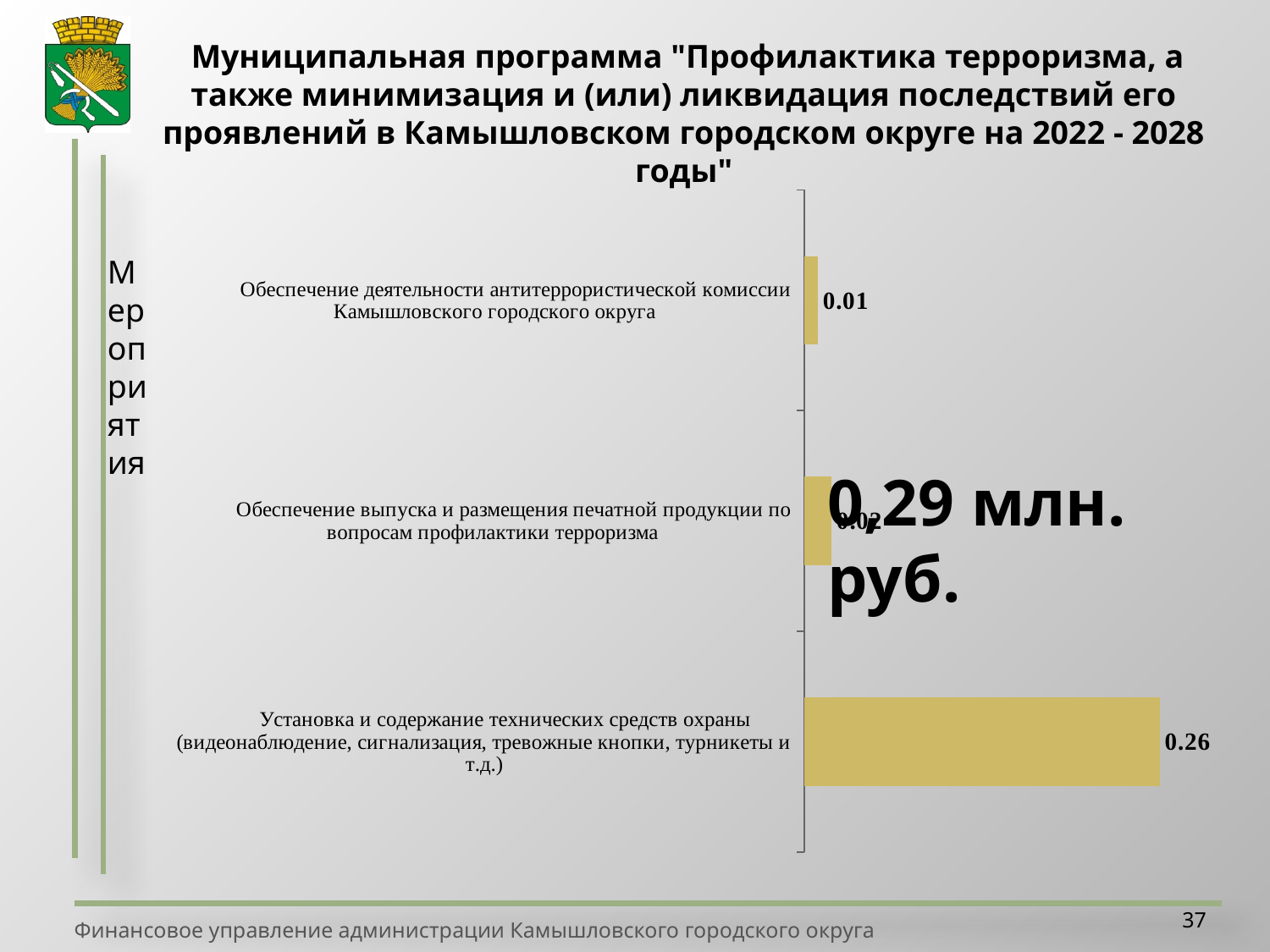
What is the title of the vertical axis of the chart? Мероприятия How many categories are shown in the chart? 3 What is the difference between the value for "Установка и содержание технических средств охраны" and the value for "Обеспечение деятельности антитеррористической комиссии"? 0.25 What kind of chart is shown on the slide? Bar chart Which is larger: the value for "Установка и содержание технических средств охраны" or the value for "Обеспечение деятельности антитеррористической комиссии"? Установка и содержание технических средств охраны Which category has the highest value? Установка и содержание технических средств охраны (видеонаблюдение, сигнализация, тревожные кнопки, турникеты и т.д.) What total amount is printed in large text over the chart? 0,29 млн. руб. Which is larger: the value for "Обеспечение выпуска и размещения печатной продукции по вопросам профилактики терроризма" or the value for "Установка и содержание технических средств охраны"? Установка и содержание технических средств охраны Which category has the lowest value? Обеспечение деятельности антитеррористической комиссии Камышловского городского округа What is the value for "Обеспечение деятельности антитеррористической комиссии Камышловского городского округа"? 0.01 What is the value for "Установка и содержание технических средств охраны (видеонаблюдение, сигнализация, тревожные кнопки, турникеты и т.д.)"? 0.26